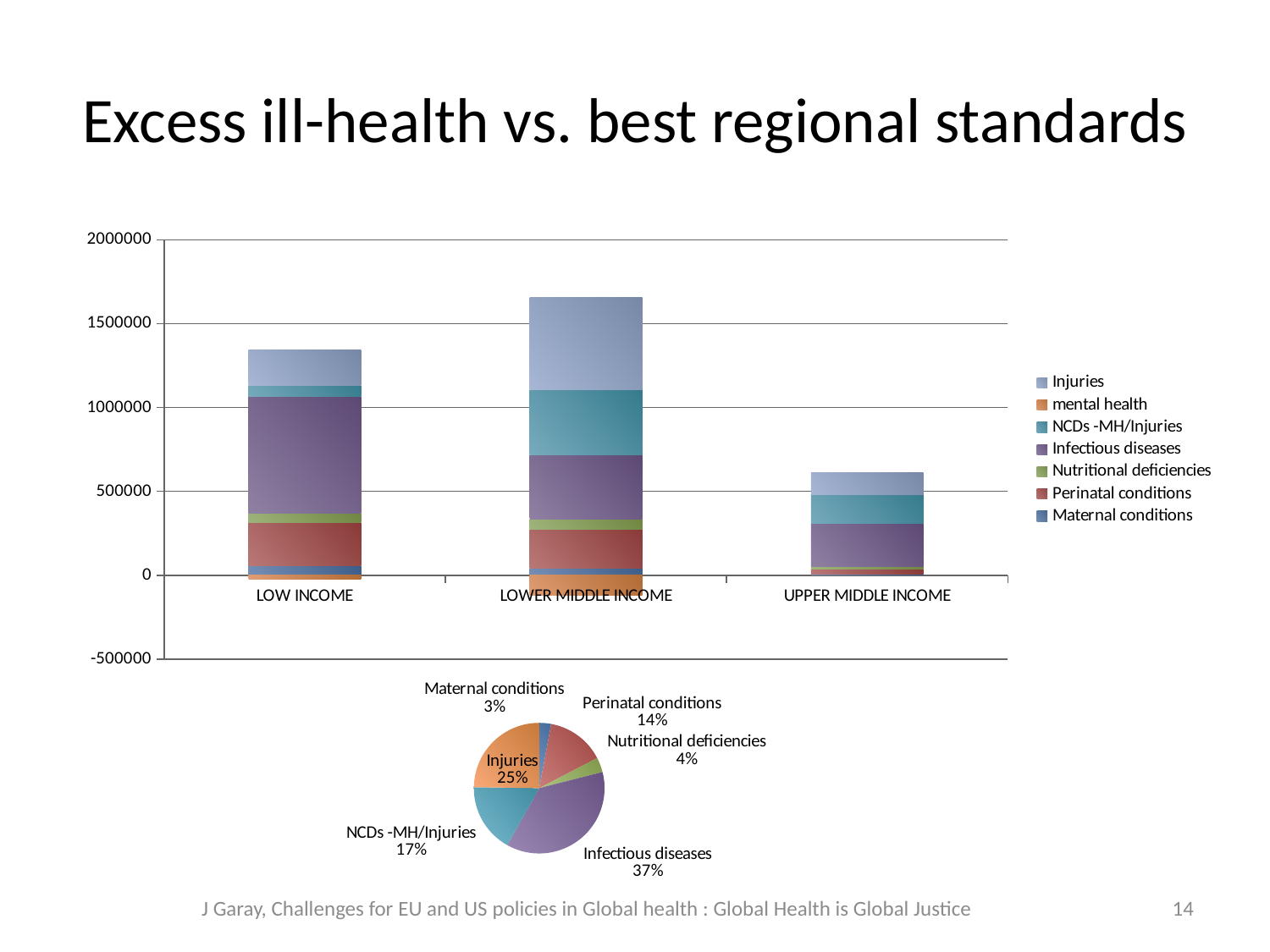
In the top bar chart, is the total height of the UPPER MIDDLE INCOME bar greater or less than 1000000? less In the bottom pie chart, which labelled slice has the smallest share? Maternal conditions In the top bar chart, is the total height of the LOWER MIDDLE INCOME bar greater or less than 1500000? greater In the top bar chart, how many income categories are shown on the x axis? 3 In the bottom pie chart, what share is labelled for Injuries? 25% In the bottom pie chart, what is the difference in percentage points between Infectious diseases and Injuries? 12% In the bottom pie chart, what share is labelled for Infectious diseases? 37% In the top bar chart, which income category has the shortest stacked bar? UPPER MIDDLE INCOME In the top bar chart, which income category has the tallest stacked bar? LOWER MIDDLE INCOME In the top bar chart, how many series does the legend list? 7 What kind of chart is the top chart on the slide? stacked bar chart What kind of chart is the bottom chart on the slide? pie chart